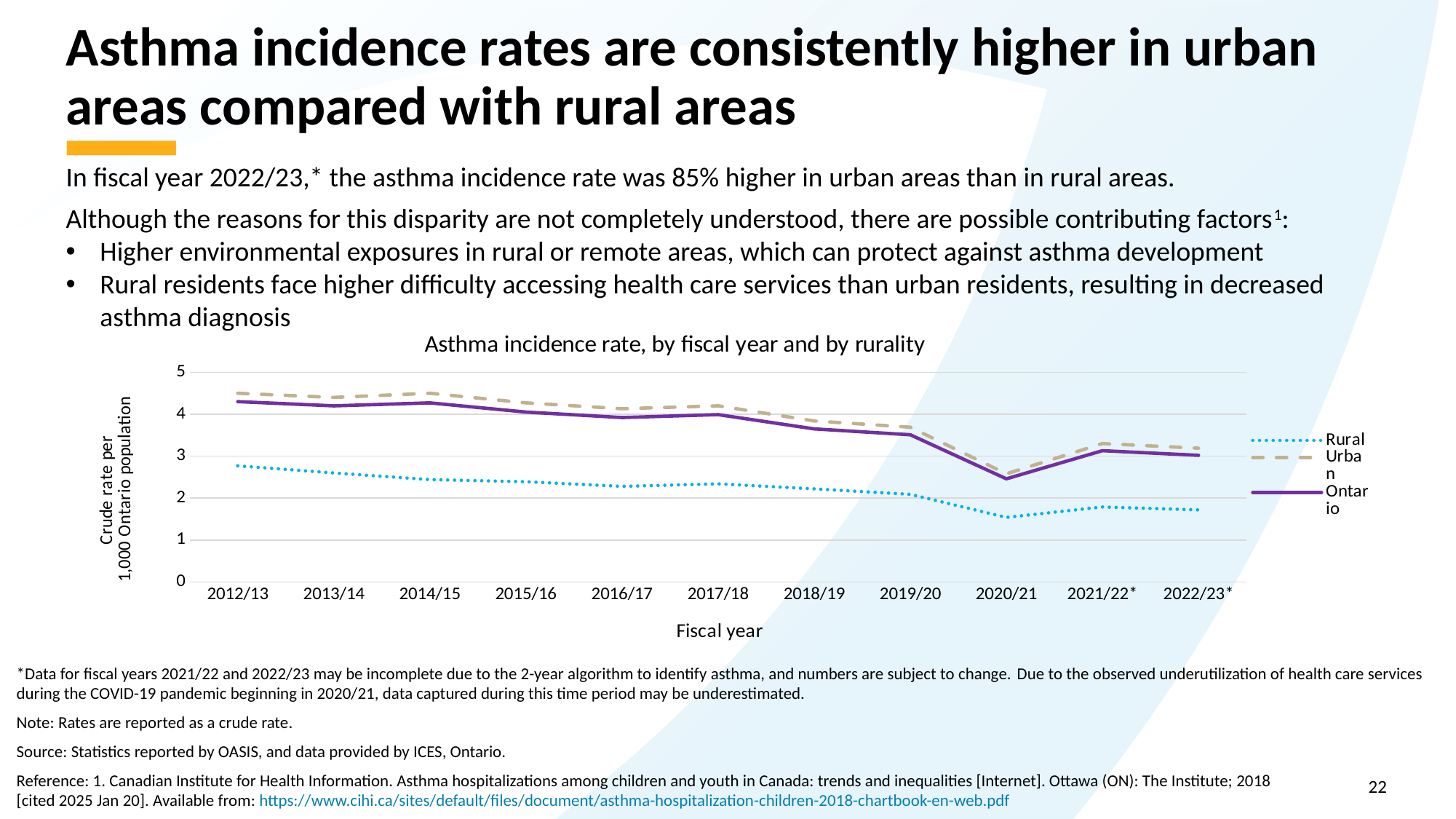
Is the Rural value for 2020/21 greater or less than 2? less What is the label of the y axis? Crude rate per 1,000 Ontario population What kind of chart is shown on the slide? Line chart In which fiscal year is the Rural series at its lowest? 2020/21 How many series does the legend list? 3 What is the title of the chart? Asthma incidence rate, by fiscal year and by rurality Is the Urban value for 2012/13 greater or less than 4? greater How many fiscal years are plotted along the x axis? 11 Is the Rural value for 2012/13 greater or less than 3? less Does the Rural series generally rise or fall from 2012/13 to 2020/21? Fall In 2022/23, which series has the larger value, Urban or Rural? Urban